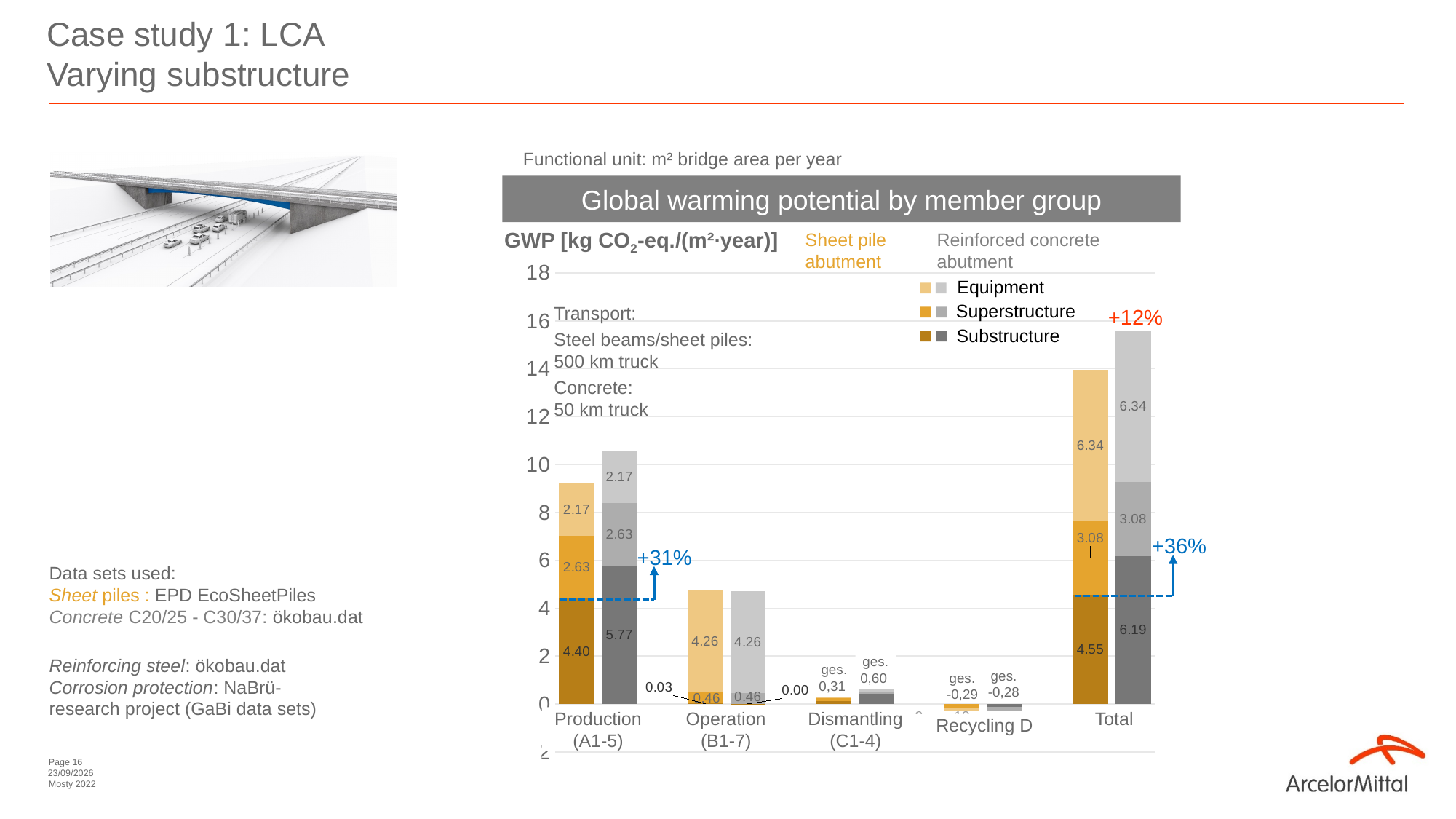
What is the total (ges.) value for the reinforced concrete abutment in the Dismantling (C1-4) stage? 0,60 What is the title of the chart? Global warming potential by member group What is the difference between the reinforced concrete and sheet pile Substructure values in the Production (A1-5) stage? 1.37 How many member groups does the chart legend list? 3 What is the Substructure value for the sheet pile abutment in the Production (A1-5) stage? 4.40 What is the Equipment value for the sheet pile abutment in the Total bar? 6.34 Which abutment type has the larger Substructure value in the Total bar, sheet pile or reinforced concrete? Reinforced concrete What is the Substructure value for the reinforced concrete abutment in the Production (A1-5) stage? 5.77 How many life-cycle stage categories are shown on the x axis of the chart? 5 What is the total height of the sheet pile abutment stacked bar in the Production (A1-5) stage? 9.20 What type of chart is shown on the slide? Stacked bar chart What is the Substructure value for the reinforced concrete abutment in the Total bar? 6.19